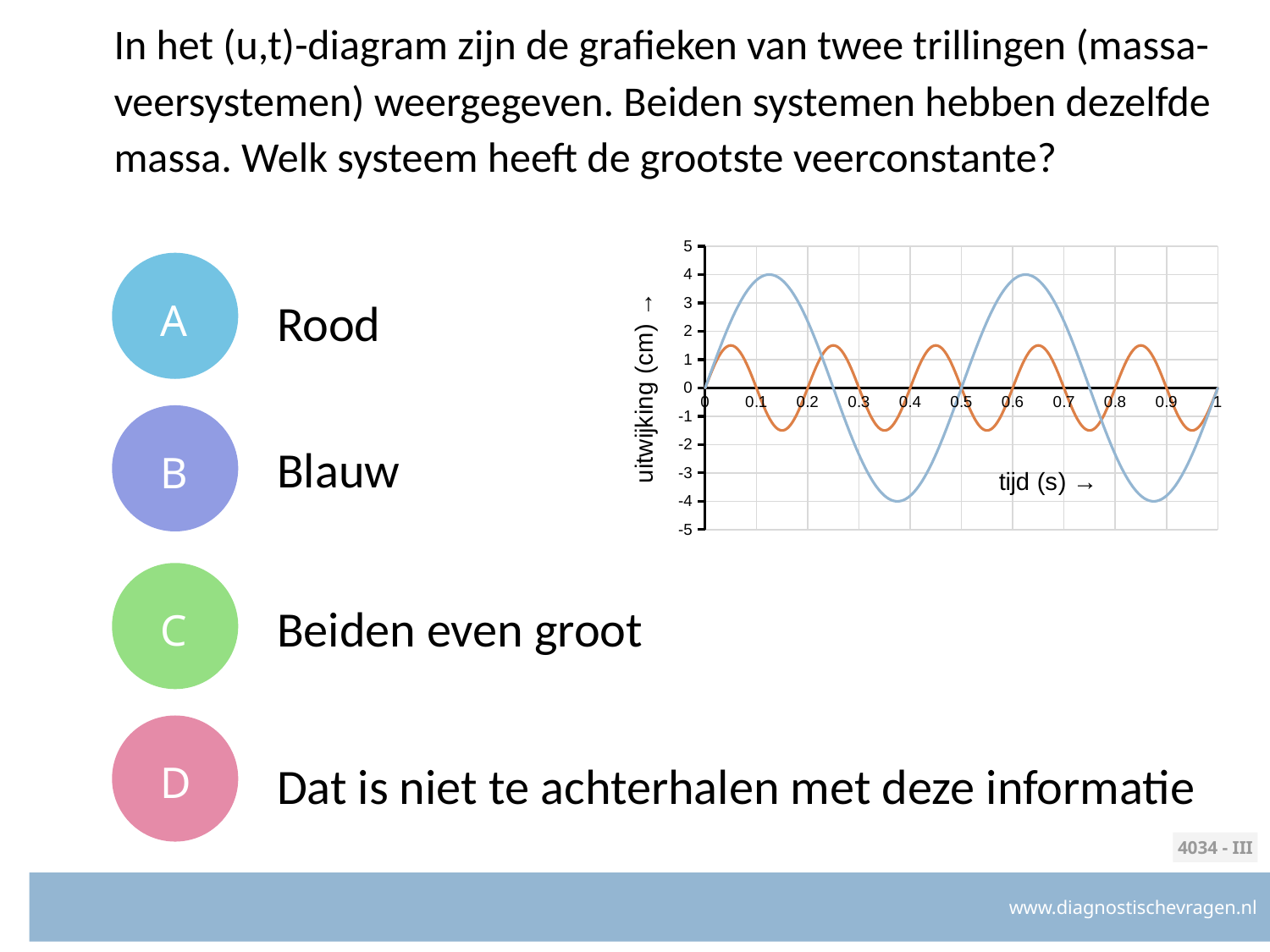
Which line reaches the higher peak value, the blue line or the orange line? blue Is the peak value of the orange line greater or less than 2? less What is the maximum value reached by the blue line? 4 What is the label of the horizontal axis of the chart? tijd (s) How many lines are plotted in the chart? 2 How many complete oscillations does the blue line make between 0 and 1 s? 2 Is the peak value of the orange line greater or less than 1? greater What kind of chart is shown on the slide? line chart How many complete oscillations does the orange line make between 0 and 1 s? 5 What is the minimum value reached by the blue line? -4 What is the label of the vertical axis of the chart? uitwijking (cm) What is the value of the blue line at time 0.5 s? 0